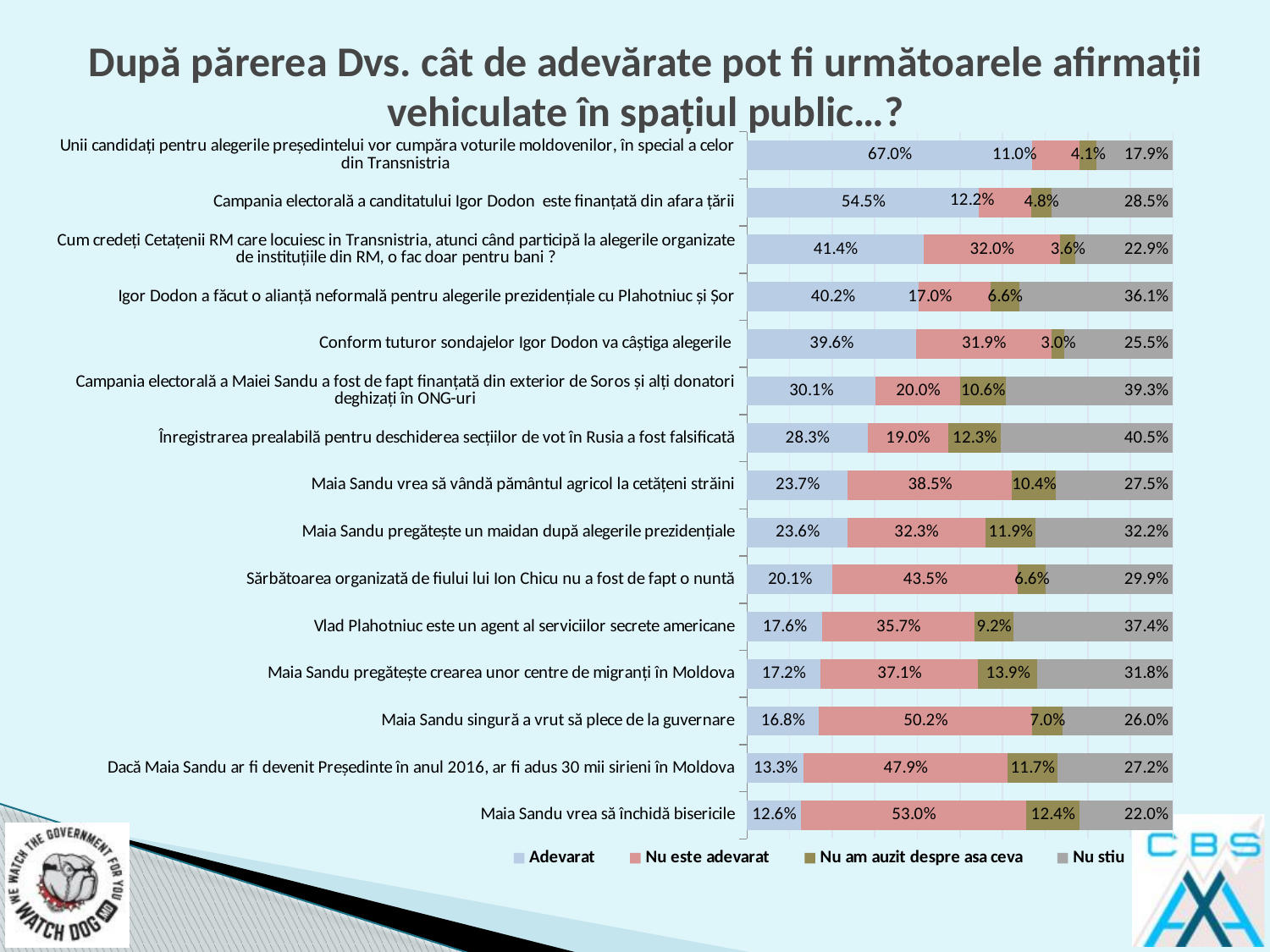
What is the "Nu stiu" value for "Igor Dodon a făcut o alianță neformală pentru alegerile prezidențiale cu Plahotniuc și Șor"? 36.1% What is the "Nu am auzit despre asa ceva" value for "Maia Sandu pregătește crearea unor centre de migranți în Moldova"? 13.9% Which statement has the lowest "Adevarat" share? Maia Sandu vrea să închidă bisericile Which has a larger "Nu este adevarat" share: "Maia Sandu vrea să vândă pământul agricol la cetățeni străini" or "Maia Sandu pregătește un maidan după alegerile prezidențiale"? Maia Sandu vrea să vândă pământul agricol la cetățeni străini What is the difference in the "Adevarat" share between the Transnistria vote-buying statement (67.0%) and "Campania electorală a candidatului Igor Dodon este finanțată din afara țării" (54.5%)? 12.5 percentage points How many series does the legend list? 4 Which statement has the highest "Nu stiu" share? Înregistrarea prealabilă pentru deschiderea secțiilor de vot în Rusia a fost falsificată What type of chart is shown on the slide? Stacked bar chart What is the "Nu este adevarat" value for "Maia Sandu singură a vrut să plece de la guvernare"? 50.2% Which statement has the highest "Adevarat" share? Unii candidați pentru alegerile președintelui vor cumpăra voturile moldovenilor, în special a celor din Transnistria How many statements are shown in the chart? 15 What percentage answered "Adevarat" for the statement "Maia Sandu vrea să închidă bisericile"? 12.6%